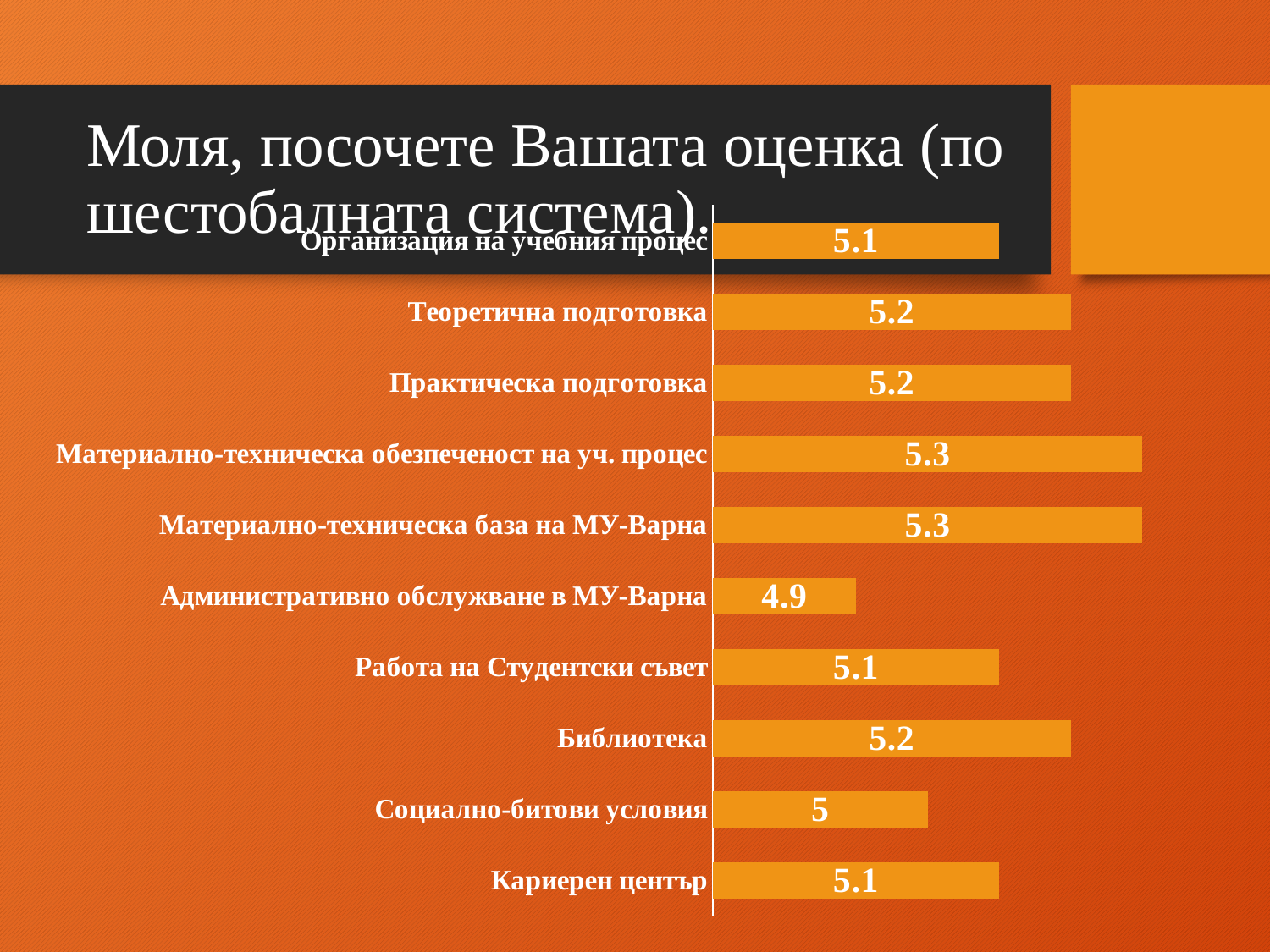
What value is shown for Кариерен център? 5.1 What value is shown for Социално-битови условия? 5 How many categories are shown in the chart? 10 What value is shown for Административно обслужване в МУ-Варна? 4.9 Which is larger, the value for Социално-битови условия or the value for Работа на Студентски съвет? Работа на Студентски съвет Which is larger, the value for Библиотека or the value for Кариерен център? Библиотека What value is shown for Библиотека? 5.2 What is the difference between the values for Материално-техническа обезпеченост на уч. процес and Социално-битови условия? 0.3 Which category has the lowest value? Административно обслужване в МУ-Варна What is the difference between the values for Теоретична подготовка and Административно обслужване в МУ-Варна? 0.3 What value is shown for Материално-техническа база на МУ-Варна? 5.3 What kind of chart is shown on the slide? bar chart